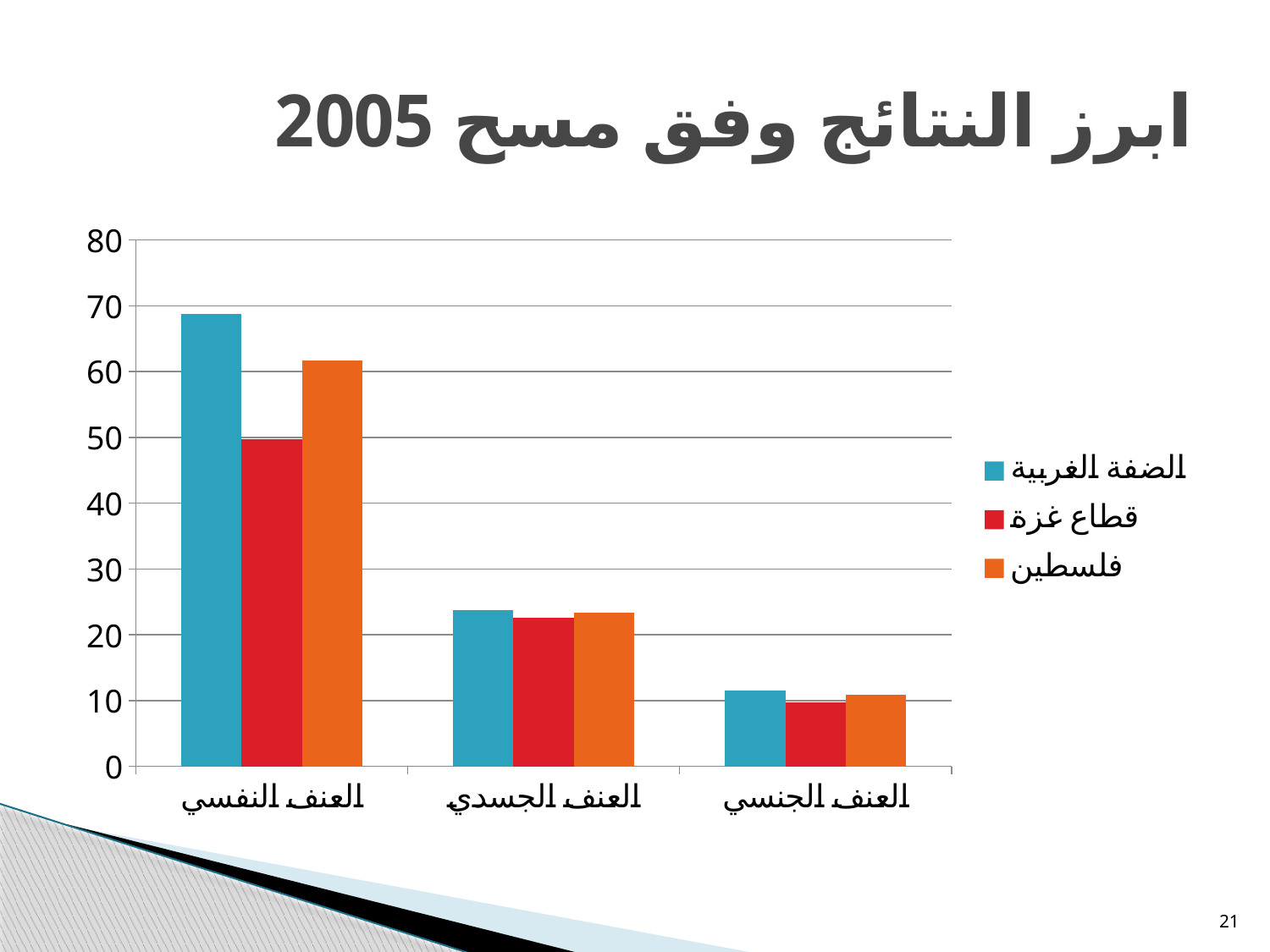
Do the values for الضفة الغربية rise or fall moving from left to right across the categories? fall How many categories are shown on the x axis of the chart? 3 How many series does the chart's legend list? 3 Which category has the lowest value for قطاع غزة? العنف الجنسي Is the value for الضفة الغربية in العنف الجسدي greater or less than 20? greater For فلسطين, which is larger: العنف النفسي or العنف الجسدي? العنف النفسي Which category has the highest value for الضفة الغربية? العنف النفسي What kind of chart is shown on the slide? Bar chart Which series is shown in red in the chart's legend? قطاع غزة For العنف النفسي, which is larger: الضفة الغربية or قطاع غزة? الضفة الغربية Is the value for فلسطين in العنف النفسي greater or less than 70? less Is the value for الضفة الغربية in العنف النفسي greater or less than 60? greater